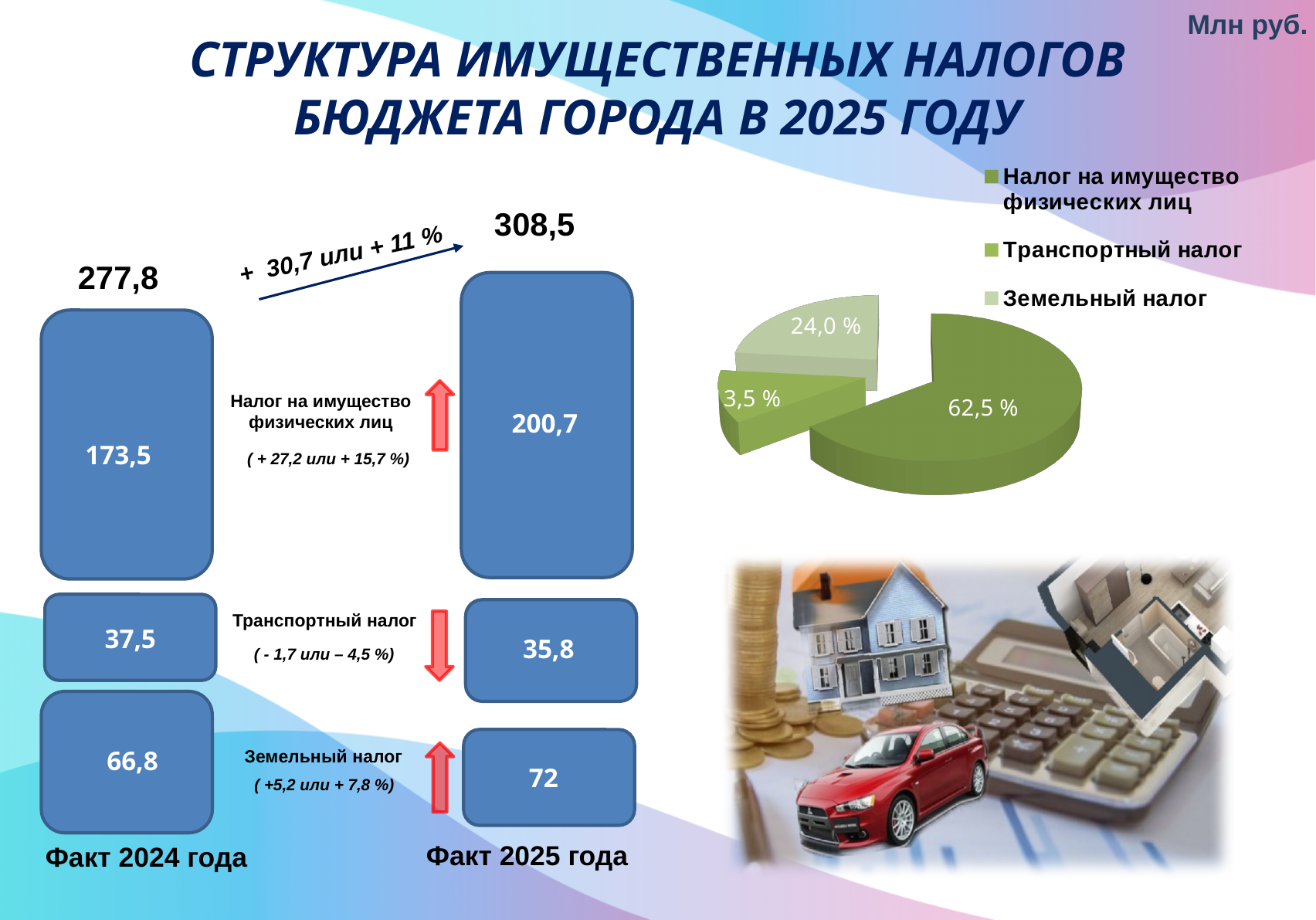
In the left diagram, what is the value of Транспортный налог for Факт 2024 года? 37,5 On the pie chart, what is the smallest share shown? 3,5 % In the left diagram, what is the total for Факт 2025 года? 308,5 How many entries does the legend of the pie chart list? 3 In the left diagram, which is larger: Земельный налог in Факт 2024 года or in Факт 2025 года? Факт 2025 года In the left diagram, what is the difference between the totals for Факт 2025 года and Факт 2024 года? 30,7 On the pie chart, what share is shown for the light green slice (Земельный налог)? 24,0 % What kind of chart is shown in the upper right of the slide? Pie chart In the left diagram, what is the value of Налог на имущество физических лиц for Факт 2025 года? 200,7 How many slices does the pie chart have? 3 On the pie chart, what share is shown for the largest slice? 62,5 % On the pie chart, which legend entry corresponds to the darkest green slice? Налог на имущество физических лиц